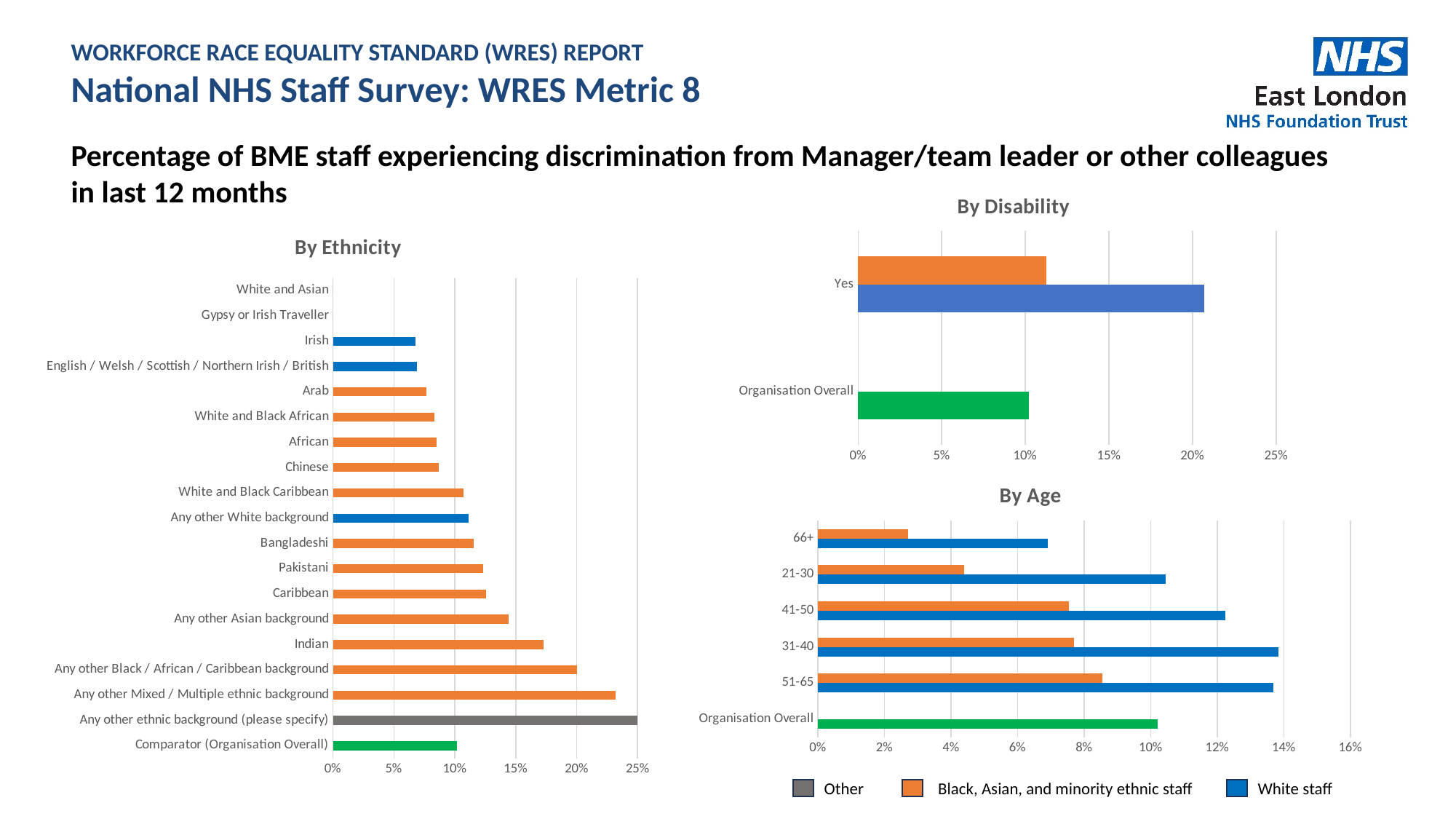
How many categories are listed on the y axis of the By Ethnicity chart? 19 In the By Ethnicity chart, is the value for Any other Mixed / Multiple ethnic background greater or less than 20%? greater In the By Ethnicity chart, which is larger: the value for Indian or the value for Caribbean? Indian In the By Ethnicity chart, is the value for Chinese greater or less than 10%? less In the By Ethnicity chart, which category has the highest value? Any other ethnic background (please specify) What kind of chart is the By Age chart? bar chart In the By Ethnicity chart, is the value for Indian greater or less than 15%? greater In the By Age chart, which age group has the lowest value for Black, Asian, and minority ethnic staff? 66+ How many series does the legend at the bottom of the slide list? 3 In the By Disability chart, which is larger for Yes: the Black, Asian, and minority ethnic staff value or the White staff value? White staff